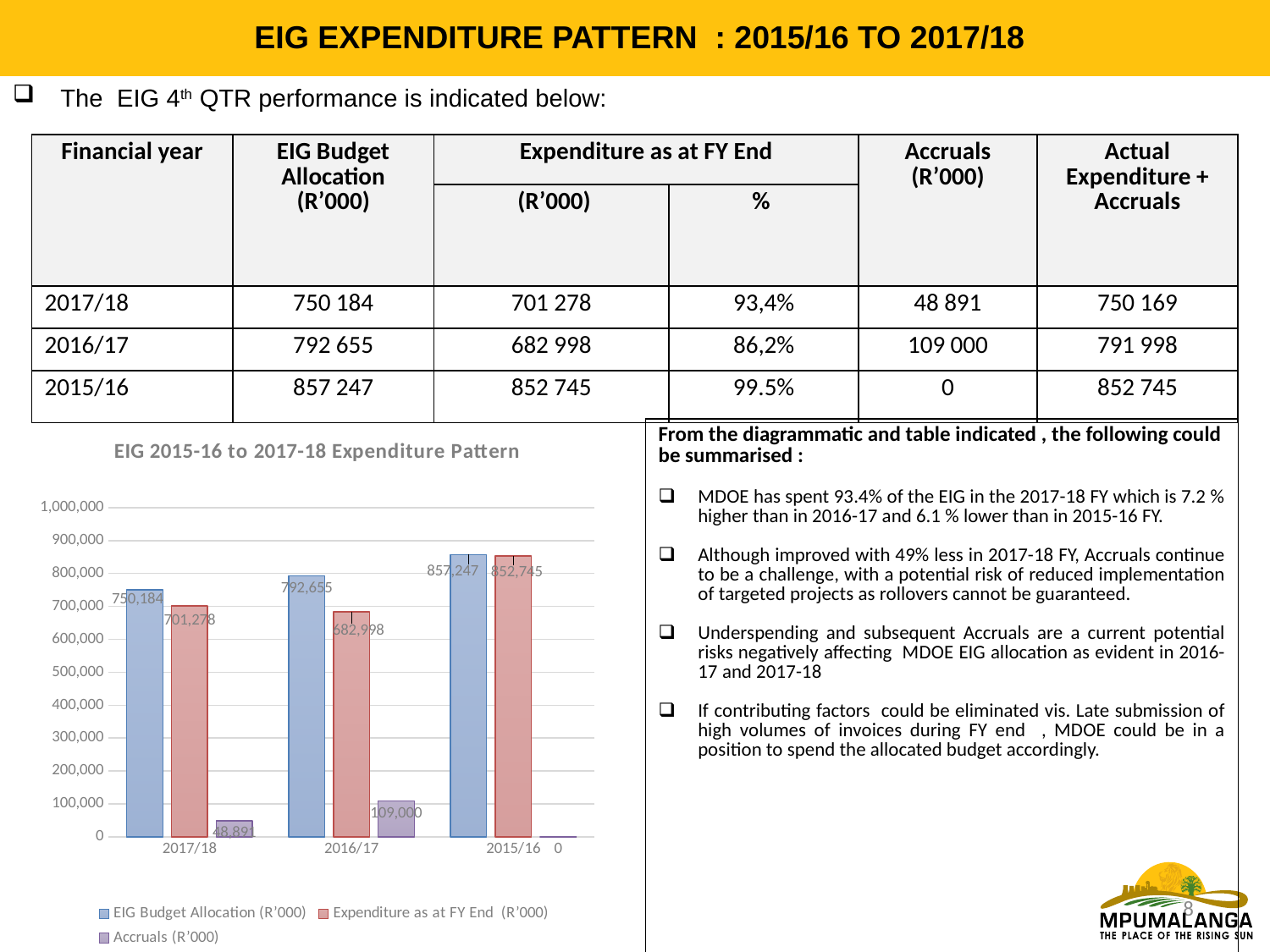
What is the difference between the EIG Budget Allocation and the Expenditure as at FY End for 2017/18 in the chart? 48,906 In the chart, is the Accruals value for 2017/18 larger or smaller than the Accruals value for 2016/17? smaller How many series does the chart legend list? 3 Which financial year has the highest EIG Budget Allocation (R'000) in the chart? 2015/16 What is the EIG Budget Allocation (R'000) value for 2017/18 in the chart? 750,184 What is the title of the chart? EIG 2015-16 to 2017-18 Expenditure Pattern Which financial year has the lowest Accruals (R'000) in the chart? 2015/16 What is the Accruals (R'000) value for 2016/17 in the chart? 109,000 How many financial years are shown on the x axis of the chart? 3 What is the Expenditure as at FY End (R'000) value for 2016/17 in the chart? 682,998 What type of chart is shown on the slide? bar chart